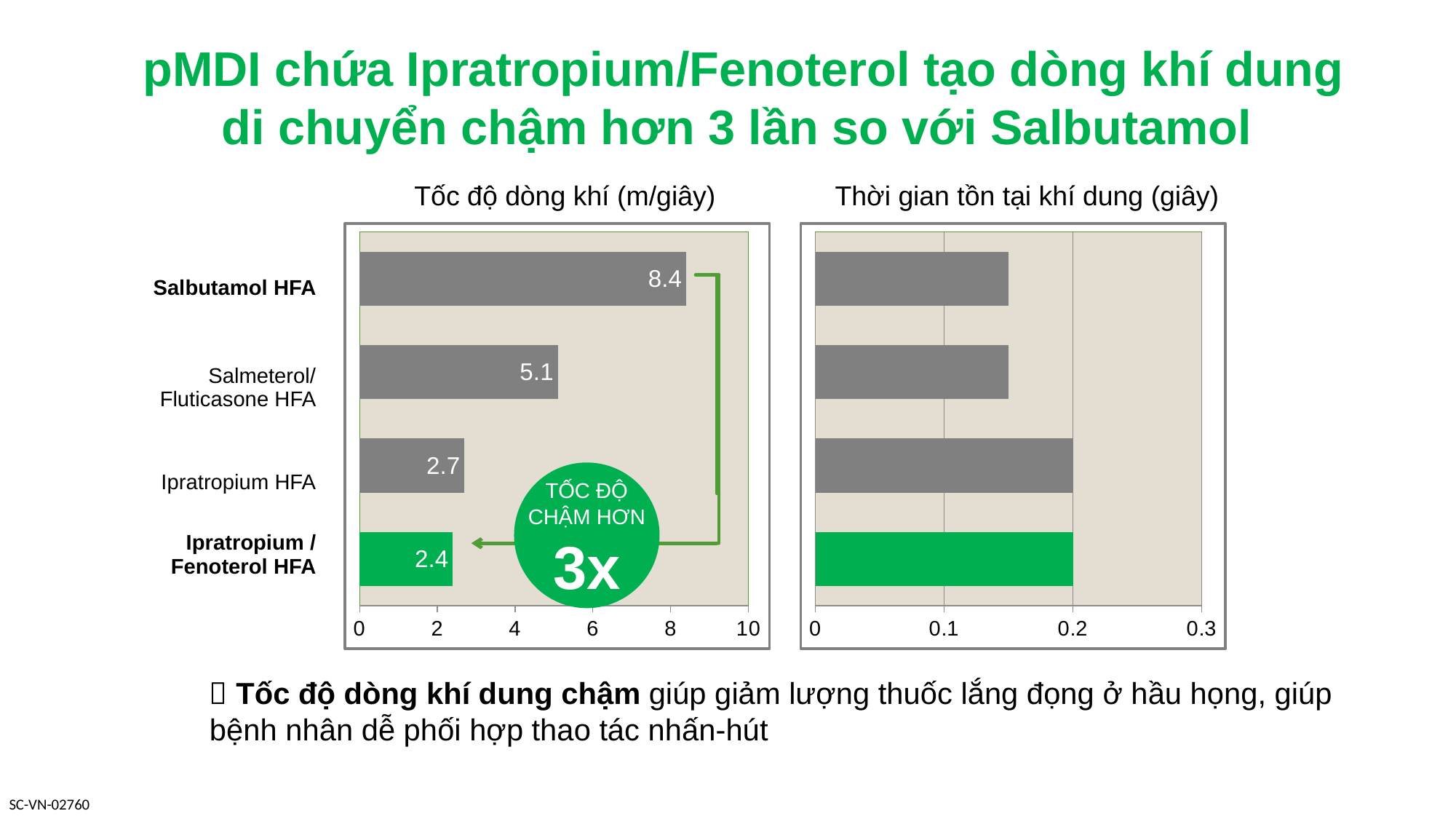
What kind of chart is the right chart (Thời gian tồn tại khí dung)? Bar chart In the left chart (Tốc độ dòng khí), which category has the lowest value? Ipratropium / Fenoterol HFA What is the title of the left chart? Tốc độ dòng khí (m/giây) In the right chart (Thời gian tồn tại khí dung), is the value for Salbutamol HFA greater or less than 0.1? greater How many categories are shown in the left chart (Tốc độ dòng khí)? 4 In the left chart (Tốc độ dòng khí), which category has the highest value? Salbutamol HFA In the right chart (Thời gian tồn tại khí dung), what is the value for Ipratropium HFA? 0.2 In the left chart (Tốc độ dòng khí), what is the value for Salmeterol/Fluticasone HFA? 5.1 In the left chart (Tốc độ dòng khí), what is the value for Salbutamol HFA? 8.4 In the left chart (Tốc độ dòng khí), which is larger: Salmeterol/Fluticasone HFA or Ipratropium HFA? Salmeterol/Fluticasone HFA In the left chart (Tốc độ dòng khí), what is the difference between Salbutamol HFA and Ipratropium / Fenoterol HFA? 6.0 In the left chart (Tốc độ dòng khí), what is the value for Ipratropium / Fenoterol HFA? 2.4